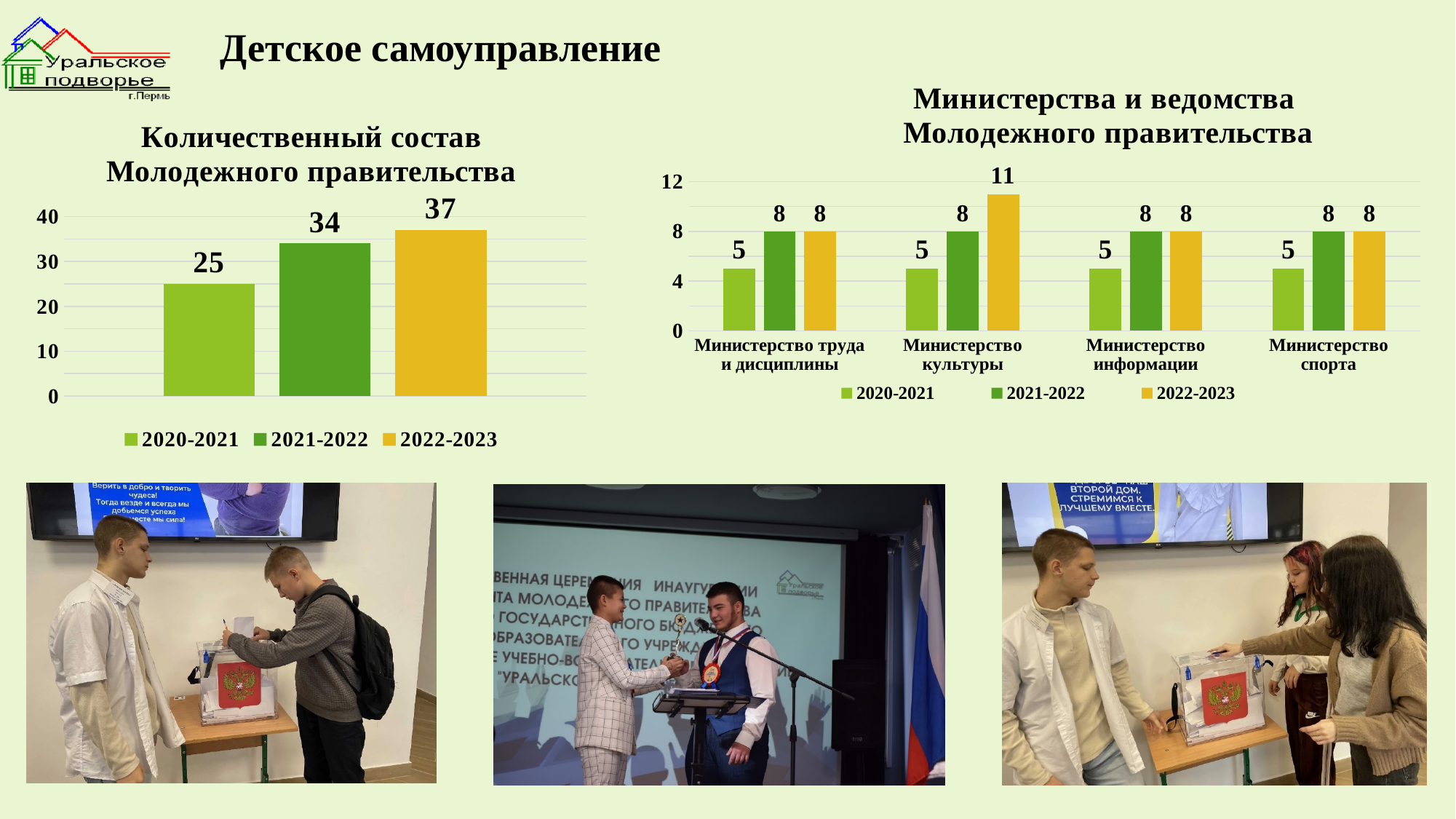
In the chart 'Количественный состав Молодежного правительства', do the values rise or fall from 2020-2021 to 2022-2023? rise In the chart 'Министерства и ведомства Молодежного правительства', what is the 2020-2021 value for Министерство спорта? 5 What kind of chart is 'Министерства и ведомства Молодежного правительства'? bar chart In the chart 'Министерства и ведомства Молодежного правительства', which ministry has the highest 2022-2023 value? Министерство культуры In the chart 'Министерства и ведомства Молодежного правительства', how many ministries are shown on the x axis? 4 In the chart 'Количественный состав Молодежного правительства', what is the value for 2021-2022? 34 In the chart 'Министерства и ведомства Молодежного правительства', what is the 2022-2023 value for Министерство культуры? 11 In the chart 'Министерства и ведомства Молодежного правительства', what is the difference between the 2022-2023 and 2020-2021 values for Министерство культуры? 6 In the chart 'Количественный состав Молодежного правительства', how many series does the legend list? 3 In the chart 'Количественный состав Молодежного правительства', which year has the lowest value? 2020-2021 In the chart 'Количественный состав Молодежного правительства', what is the difference between the 2022-2023 and 2020-2021 values? 12 In the chart 'Количественный состав Молодежного правительства', which year has the highest value? 2022-2023